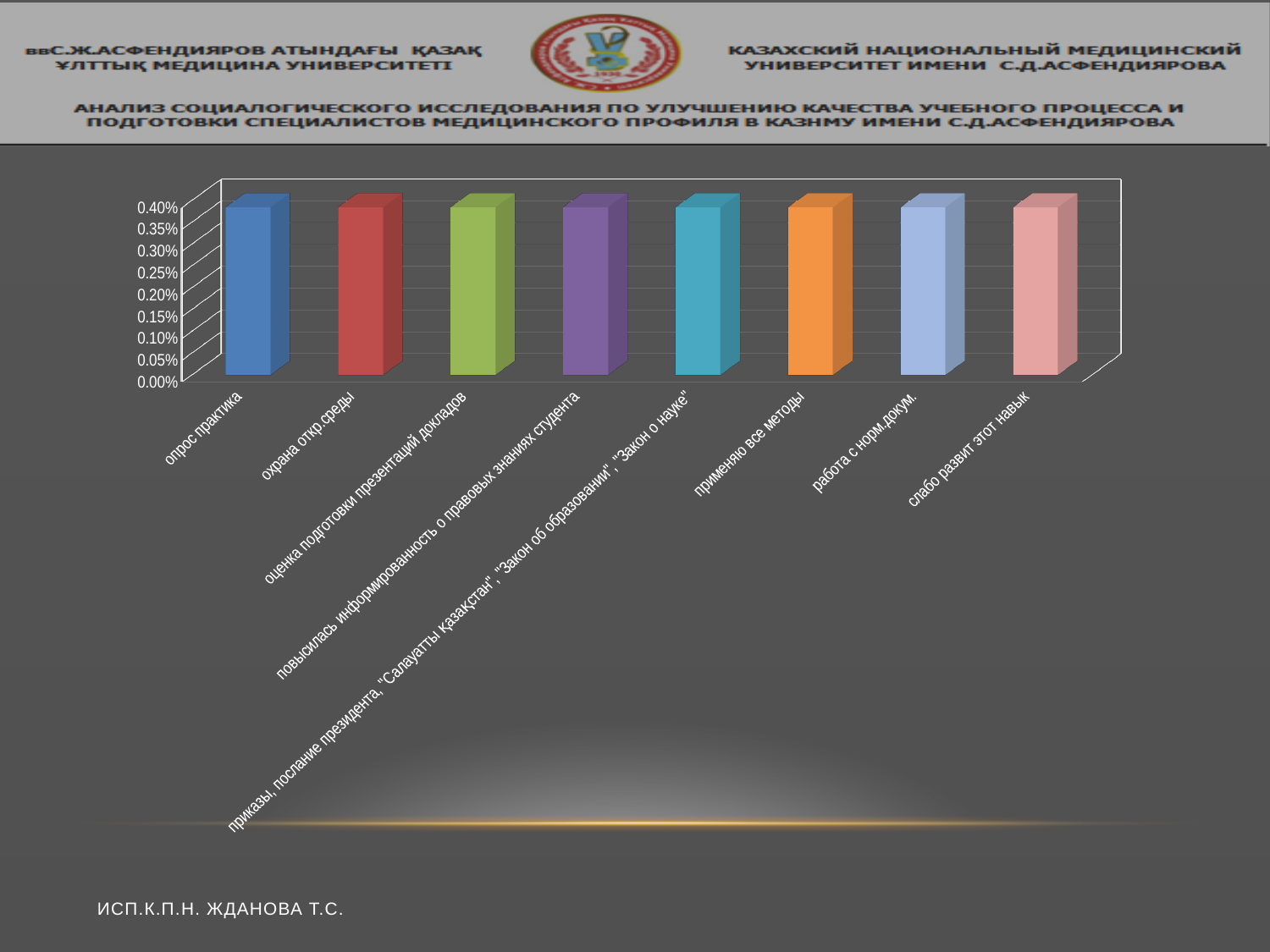
Is the value for "опрос практика" greater or less than 0.20%? greater What is the highest value shown on the vertical axis? 0.40% What kind of chart is shown on the slide? bar chart What is the label of the first (leftmost) category on the chart? опрос практика Is the value for "применяю все методы" greater or less than 0.25%? greater How many categories (bars) does the chart show? 8 Is the value for "работа с норм.докум." greater or less than 0.15%? greater Do the bar values rise, fall, or stay roughly flat from left to right across the categories? stay flat